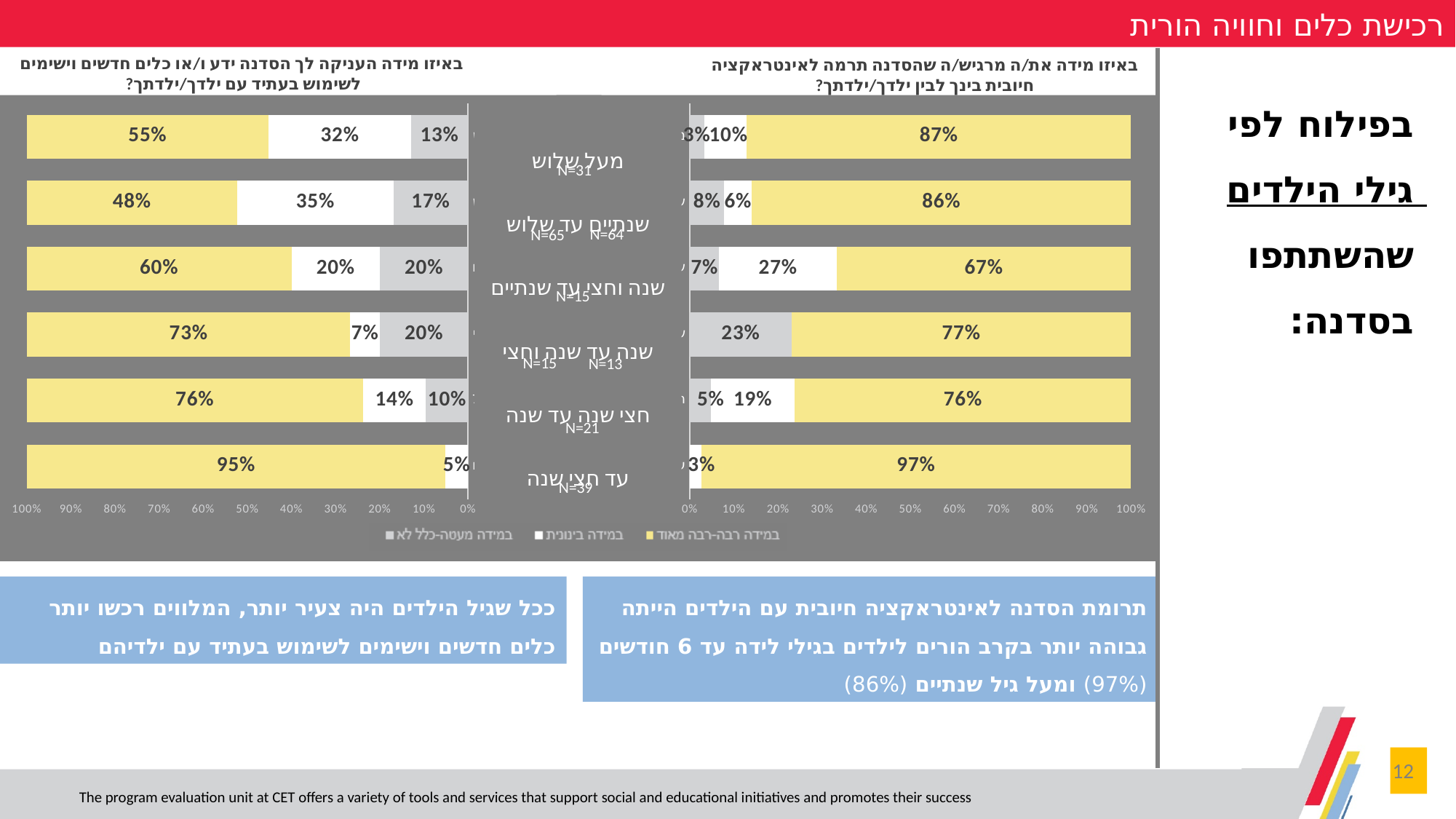
In the right chart, which age group has the highest share of במידה רבה-רבה מאוד answers? עד חצי שנה How many age groups are shown in each chart? 6 In the right chart, what percentage of parents of children aged שנה וחצי עד שנתיים answered במידה בינונית? 27% What type of chart is used on this slide? Stacked bar chart How many series does the legend list? 3 In the left chart (about new and applicable tools), what percentage of parents of children aged עד חצי שנה answered במידה רבה-רבה מאוד? 95% In the left chart, what percentage of parents of children aged שנתיים עד שלוש answered במידה בינונית? 35% In the left chart, what is the difference between the במידה רבה-רבה מאוד share for עד חצי שנה and for מעל שלוש? 40% In the left chart, which age group has the lowest share of במידה רבה-רבה מאוד answers? שנתיים עד שלוש What is the sample size (N) shown for the age group חצי שנה עד שנה? N=21 In the right chart, which age group has a larger במידה רבה-רבה מאוד share: שנה עד שנה וחצי or שנה וחצי עד שנתיים? שנה עד שנה וחצי In the right chart (about positive interaction), what percentage of parents of children aged מעל שלוש answered במידה רבה-רבה מאוד? 87%